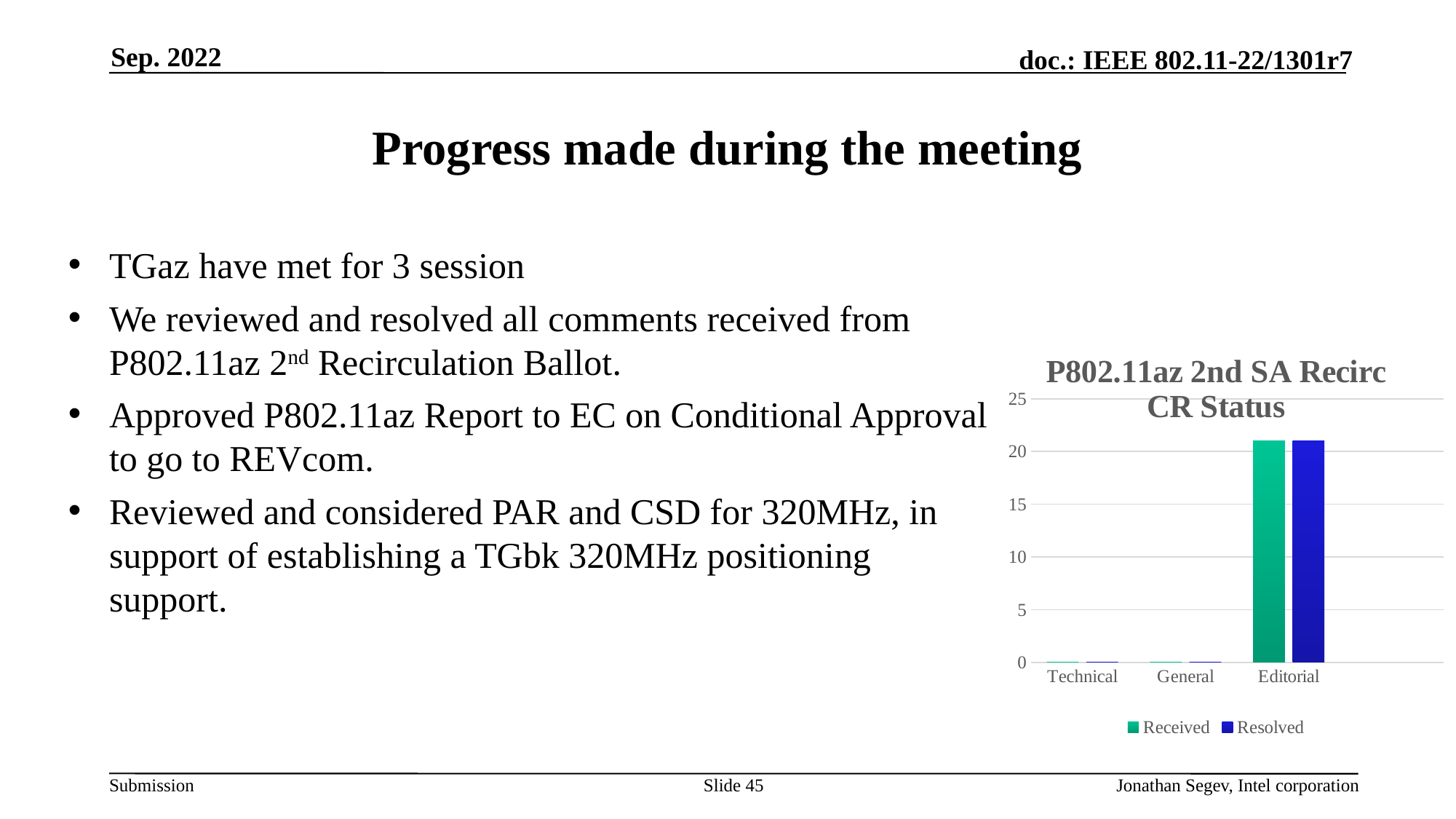
Is the Received value for Technical greater or less than 5? less Is the Resolved value for General greater or less than 5? less Which is larger, the Received value for Editorial or the Received value for General? Editorial What are the two series named in the chart legend? Received and Resolved How many categories are shown on the x axis of the chart? 3 How many series does the chart legend list? 2 What is the title of the chart? P802.11az 2nd SA Recirc CR Status Which category has the highest Resolved value in the chart? Editorial Is the Received value for Editorial greater or less than 15? greater What type of chart is shown on the slide? bar chart Which category has the highest Received value in the chart? Editorial